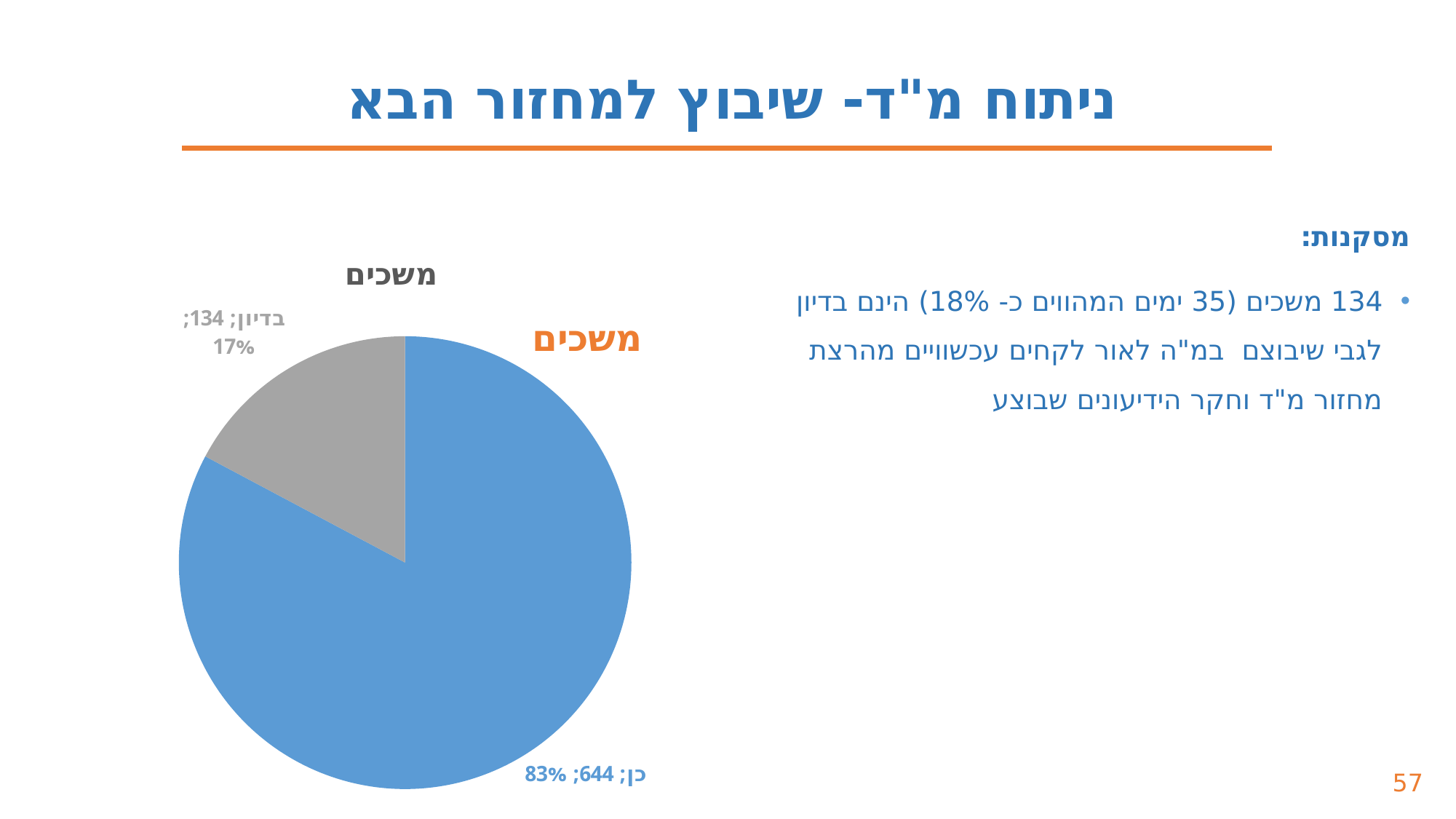
What is the difference between the values for "כן" and "בדיון"? 510 Which slice is the smallest in the pie chart? בדיון What is the value for the slice labelled "כן"? 644 What kind of chart is shown on the slide? pie chart What is the title of the pie chart? משכים What share of the pie does the "כן" slice represent? 83% What share of the pie does the "בדיון" slice represent? 17% How many slices does the pie chart have? 2 Which slice is the largest in the pie chart? כן Which is larger, the value for "כן" or the value for "בדיון"? כן What is the value for the slice labelled "בדיון"? 134 What colour is the "בדיון" slice in the pie chart? gray